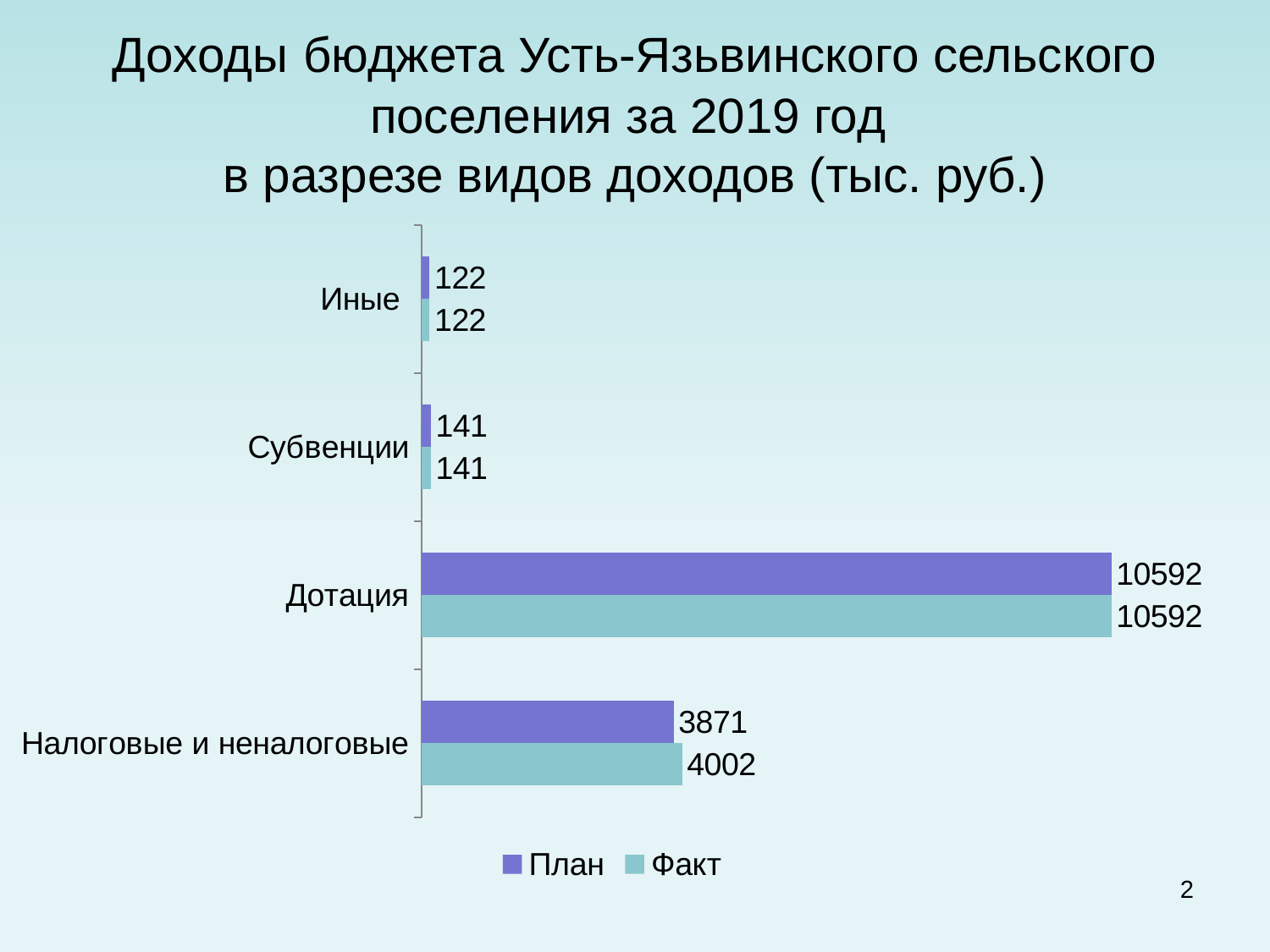
What is the difference between the Факт and План values for Налоговые и неналоговые? 131 What is the План value for Субвенции? 141 What is the Факт value for Дотация? 10592 How many series does the legend list? 2 What is the Факт value for Налоговые и неналоговые? 4002 How many categories are shown on the chart? 4 What is the План value for Налоговые и неналоговые? 3871 Which category has the lowest План value? Иные What kind of chart is shown on the slide? Bar chart Which is larger for Налоговые и неналоговые, the План value or the Факт value? Факт What is the Факт value for Иные? 122 Which category has the highest Факт value? Дотация